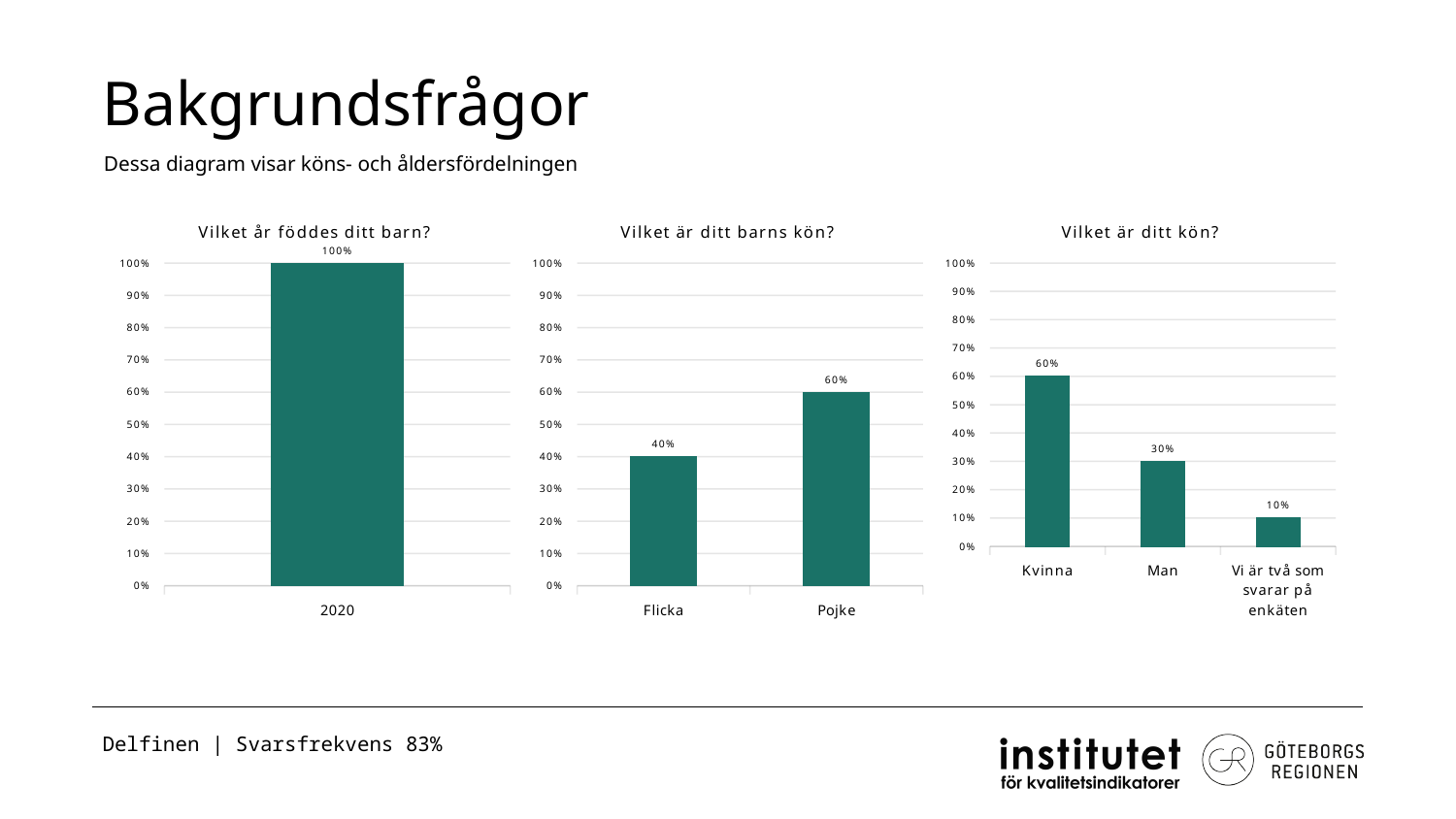
In the chart 'Vilket är ditt barns kön?', what is the difference between Pojke and Flicka? 20% In the chart 'Vilket är ditt kön?', how many categories are shown? 3 How many charts are shown on the slide? 3 In the chart 'Vilket är ditt barns kön?', which category has the highest value? Pojke In the chart 'Vilket är ditt kön?', what is the value for Man? 30% In the chart 'Vilket år föddes ditt barn?', what is the value for 2020? 100% In the chart 'Vilket är ditt kön?', which category has the lowest value? Vi är två som svarar på enkäten What kind of chart is 'Vilket är ditt barns kön?'? Bar chart In the chart 'Vilket är ditt kön?', what is the difference between Kvinna and Man? 30% In the chart 'Vilket är ditt barns kön?', what is the value for Flicka? 40% In the chart 'Vilket är ditt barns kön?', what is the value for Pojke? 60% In the chart 'Vilket är ditt kön?', what is the value for Kvinna? 60%